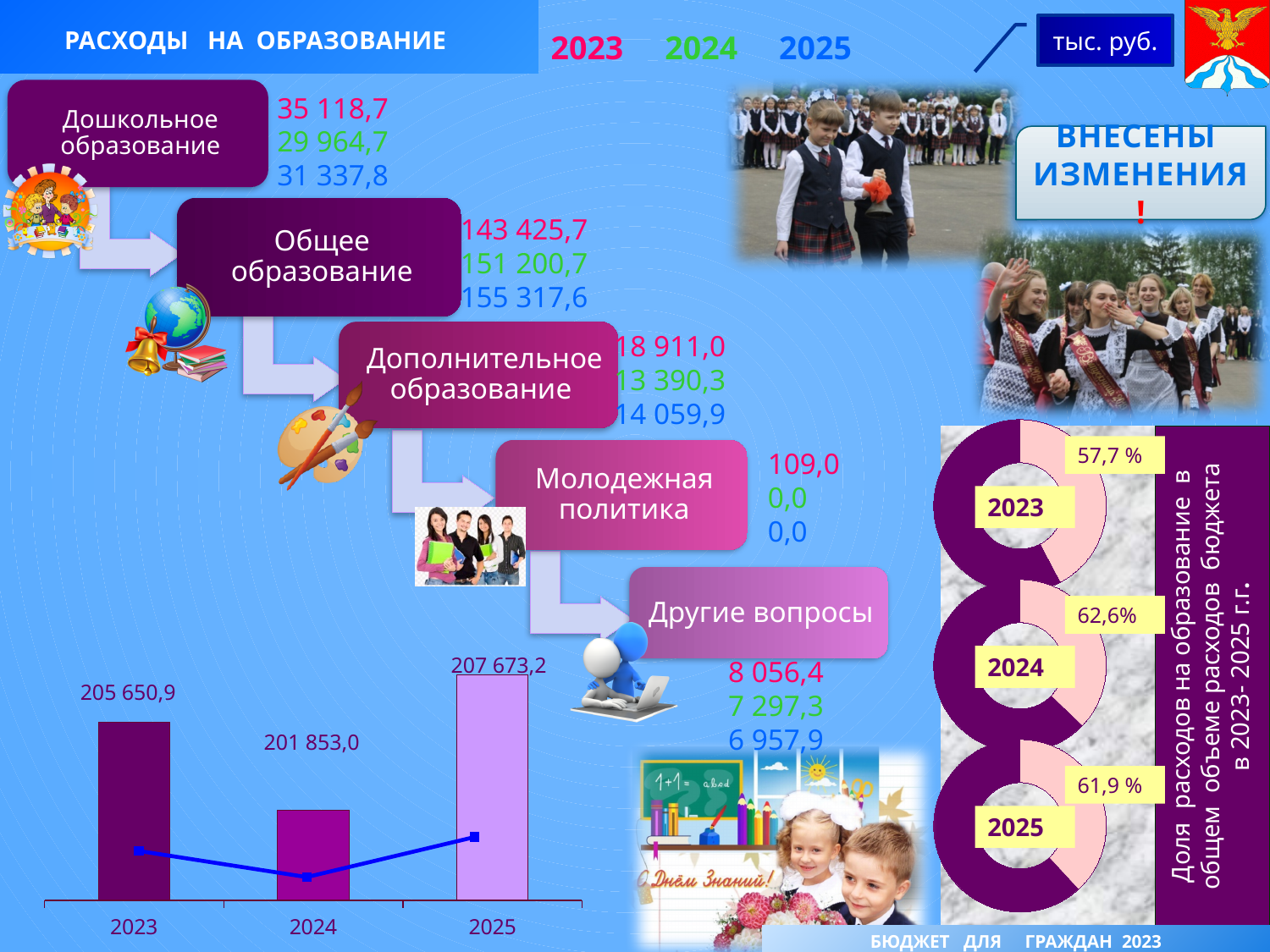
In the bar chart at the bottom left, which year has the lowest value? 2024 In the bar chart at the bottom left, what is the difference between the values for 2025 and 2023? 2 022,3 How many years are shown in the bar chart at the bottom left? 3 In the bar chart at the bottom left, which is larger, the value for 2023 or the value for 2024? 2023 In the bar chart at the bottom left, what is the difference between the values for 2023 and 2024? 3 797,9 What kind of chart is shown at the bottom left of the slide? bar chart In the donut charts on the right (share of education spending in total budget expenditure), what is the value for 2024? 62,6% In the bar chart at the bottom left, what is the value for 2024? 201 853,0 In the bar chart at the bottom left, what is the value for 2023? 205 650,9 In the bar chart at the bottom left, which year has the highest value? 2025 In the bar chart at the bottom left, what is the value for 2025? 207 673,2 In the donut charts on the right (share of education spending in total budget expenditure), which year has the highest share? 2024